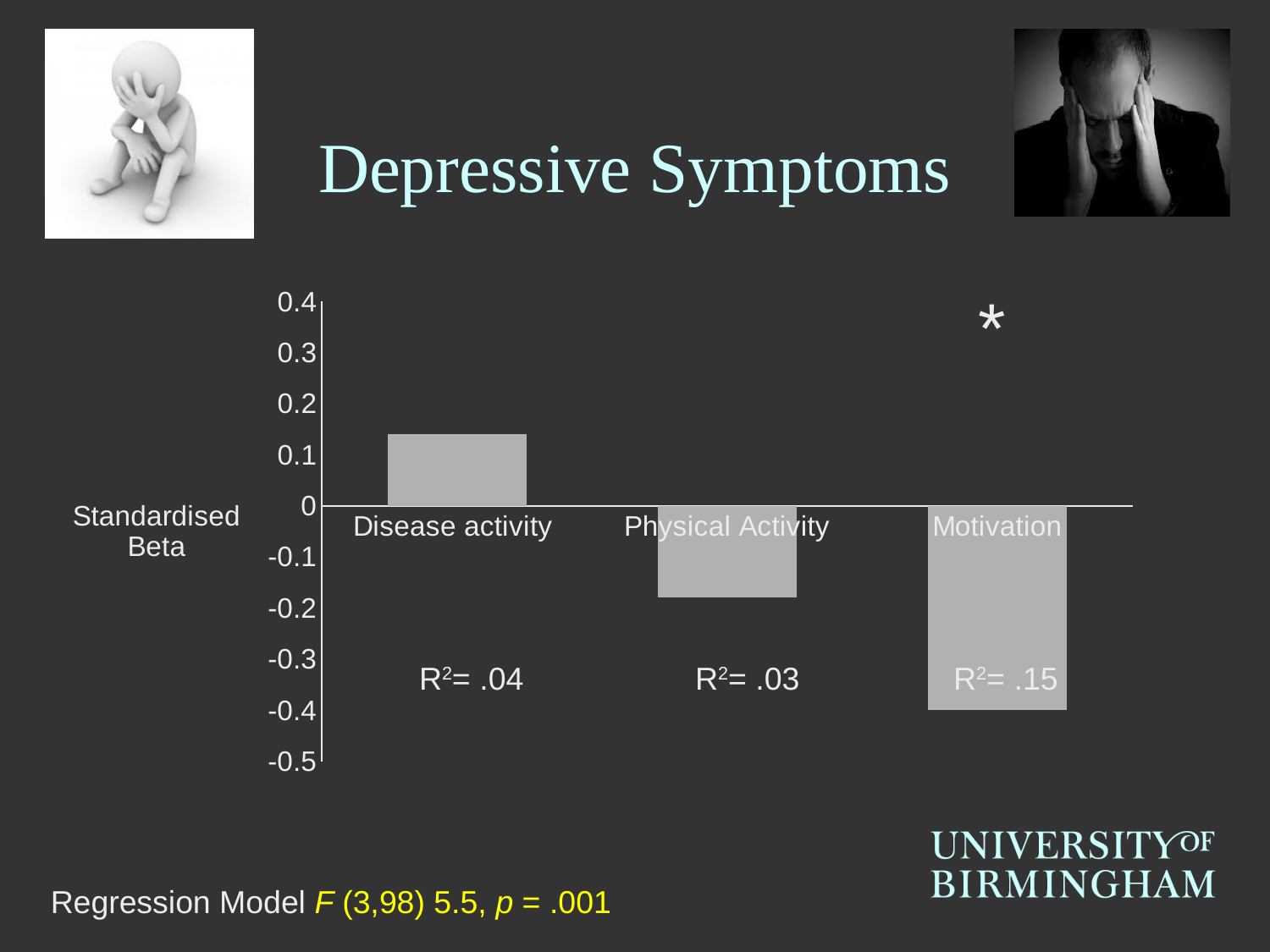
Which category has the lowest standardised beta? Motivation What R² value is shown for Motivation? R²= .15 How many categories are plotted in the chart? 3 Is the standardised beta for Motivation greater or less than -0.3? less What is the title of the slide containing the chart? Depressive Symptoms What kind of chart is shown on the slide? bar chart Is the standardised beta for Disease activity greater or less than 0.1? greater What R² value is shown for Disease activity? R²= .04 What is the label on the vertical axis of the chart? Standardised Beta Which category has the highest standardised beta? Disease activity Which has the larger standardised beta, Physical Activity or Motivation? Physical Activity Is the standardised beta for Physical Activity greater or less than -0.1? less